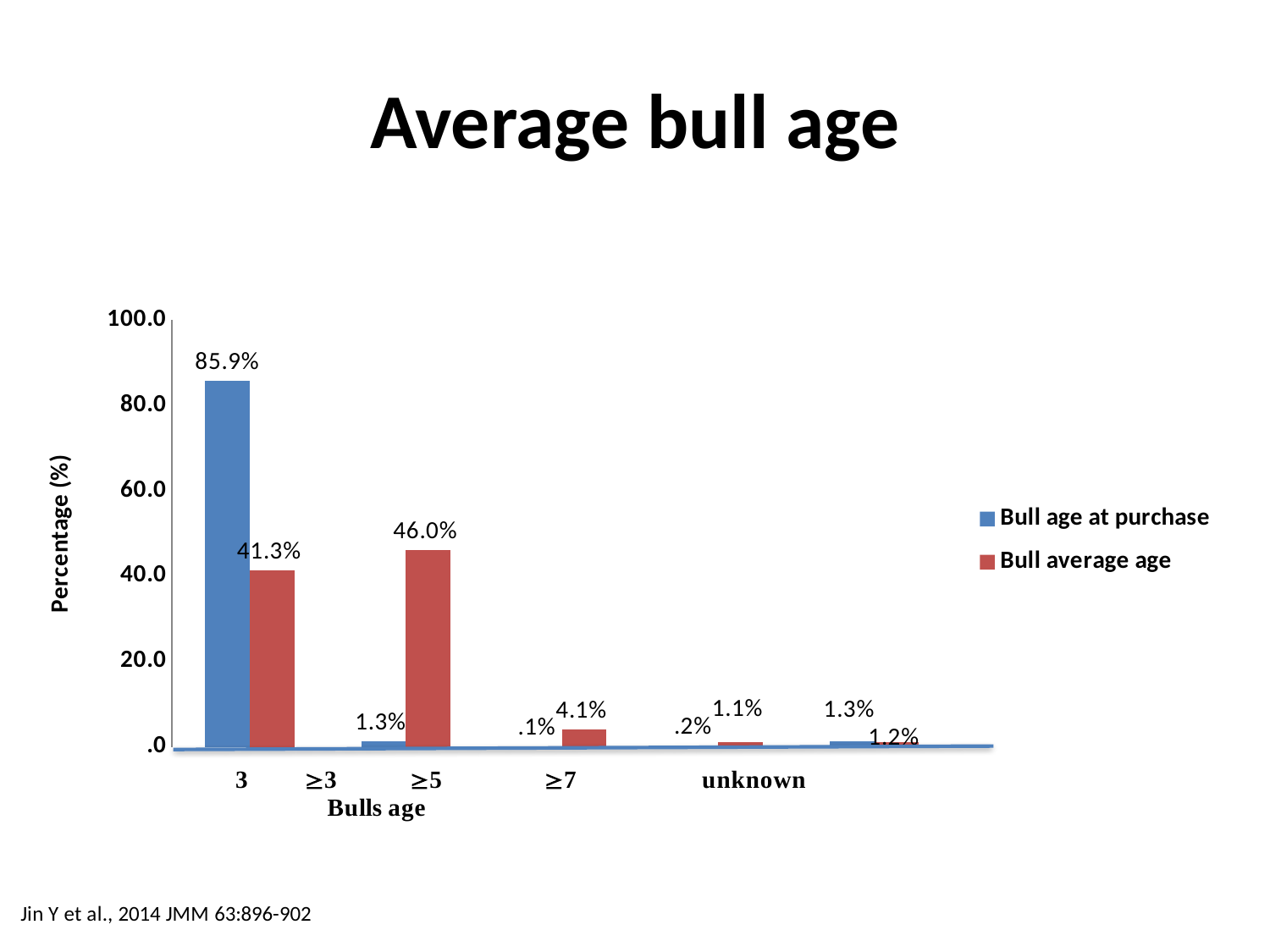
How many series does the legend list? 2 How many categories are labeled on the x axis? 5 What is the highest value plotted for the Bull average age series? 46.0% What is the difference between Bull age at purchase and Bull average age for the category 3? 44.6% What is the highest value plotted for the Bull age at purchase series? 85.9% For the category 3, which series has the larger value, Bull age at purchase or Bull average age? Bull age at purchase What is the title of the slide? Average bull age What are the two series named in the legend? Bull age at purchase; Bull average age What is the value of Bull age at purchase for the category 3? 85.9% What type of chart is shown on the slide? bar chart What is the lowest labeled value for the Bull age at purchase series? .1% What is the value of Bull average age for the category 3? 41.3%